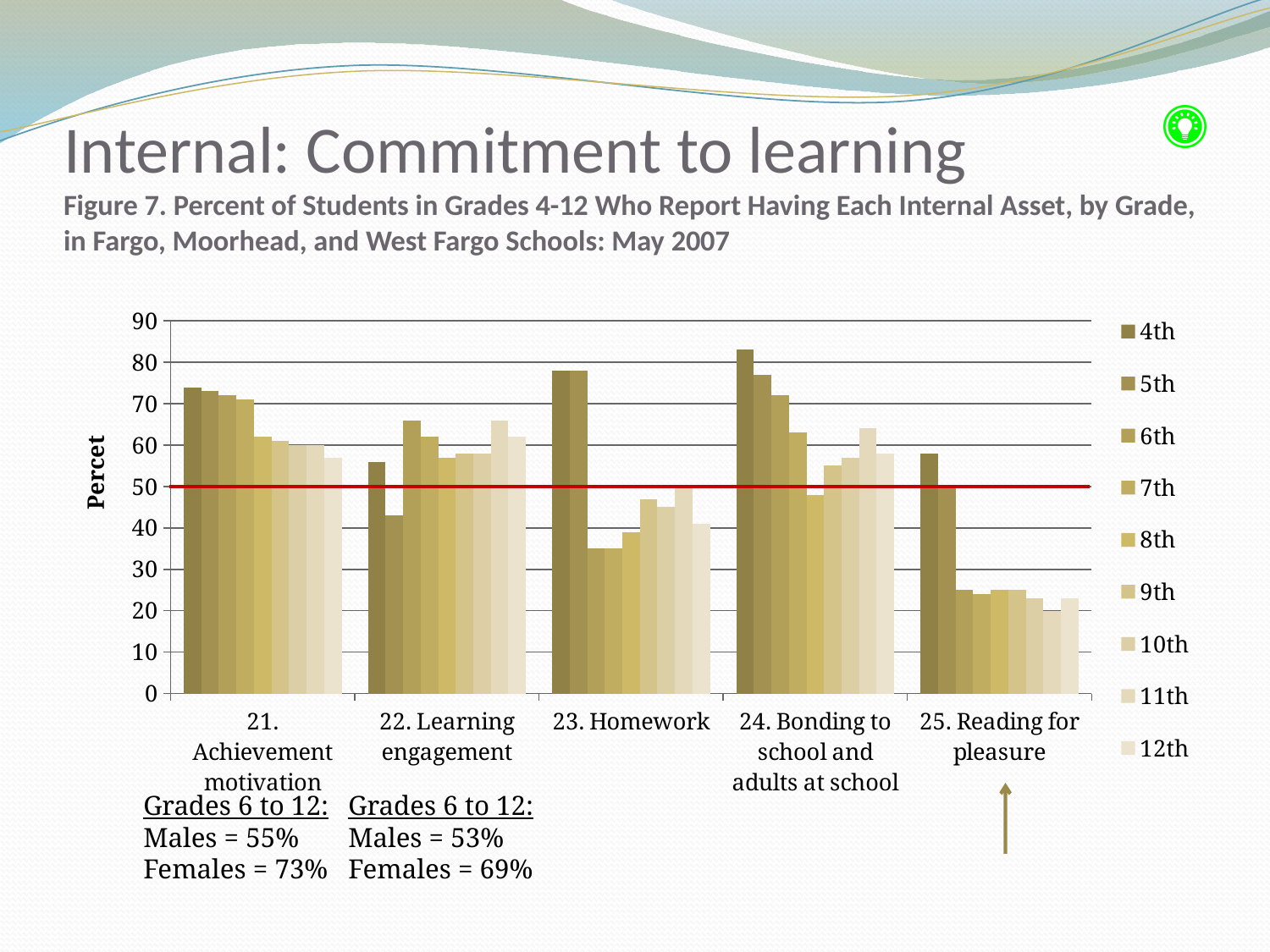
Is the value for 5th grade in '22. Learning engagement' greater or less than 50? less How many series (grades) does the legend list? 9 In '25. Reading for pleasure', do the values generally rise or fall from 4th grade to 12th grade? fall Which is larger: the 4th grade value for '21. Achievement motivation' or the 4th grade value for '22. Learning engagement'? 21. Achievement motivation Which category has the lowest 12th grade bar? 25. Reading for pleasure Is the value for 4th grade in '23. Homework' greater or less than 70? greater Is the value for 4th grade in '24. Bonding to school and adults at school' greater or less than 80? greater What kind of chart is shown on the slide? bar chart At what value on the y axis is the red horizontal line drawn across the chart? 50 Which category has the highest 4th grade bar? 24. Bonding to school and adults at school How many asset categories are shown along the x axis of the chart? 5